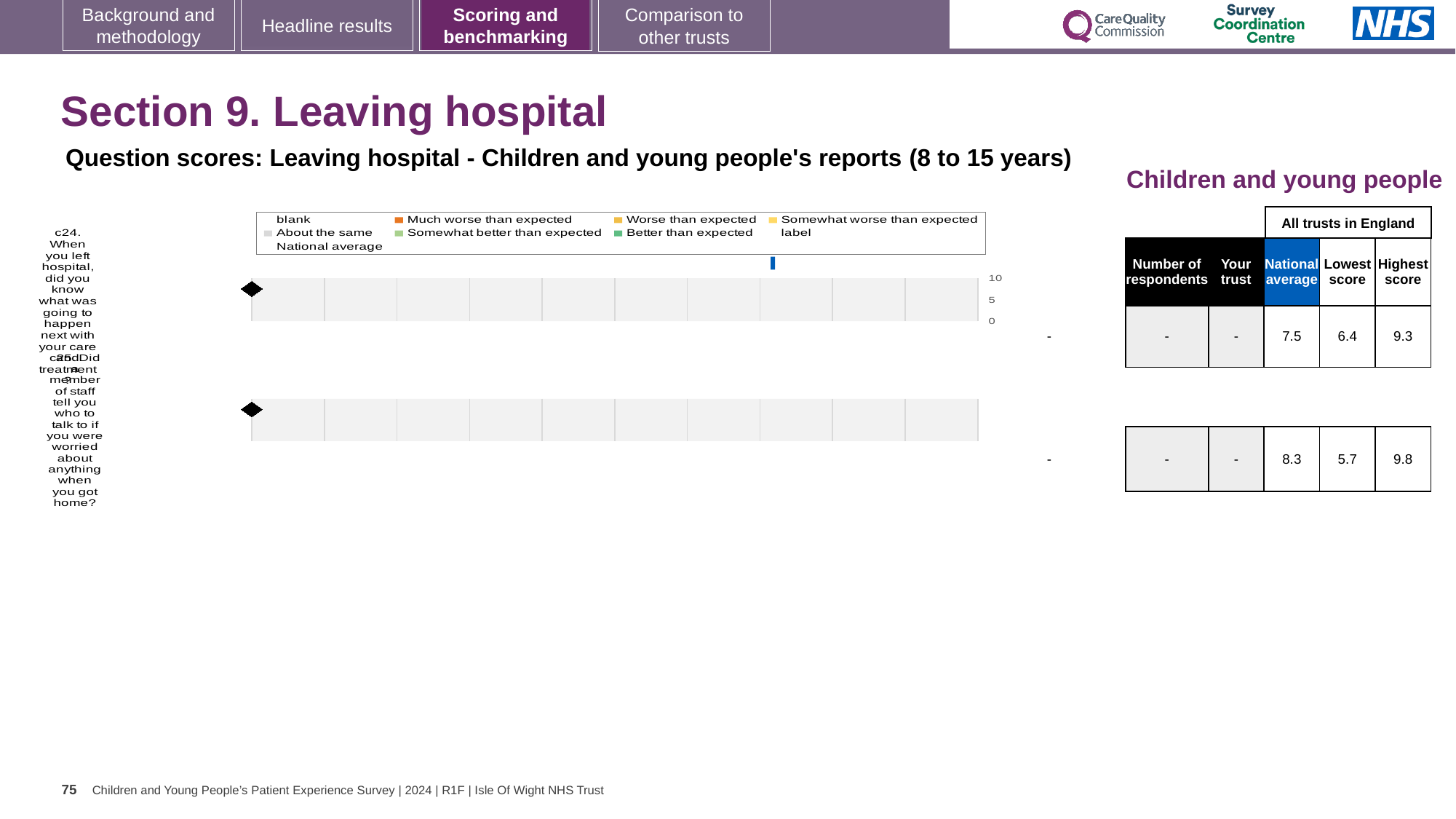
How many question categories (rows) does the chart show? 2 In the table beside the chart, what is the lowest score for question c24? 6.4 In the table beside the chart, what is the highest score for question c25? 9.8 In the table beside the chart, what is the highest score for question c24? 9.3 What kind of chart is shown on the slide? bar chart What is the highest value shown on the chart's numeric axis? 10 In the table beside the chart, what is the national average score for question c24? 7.5 In the table beside the chart, what is the national average score for question c25? 8.3 In the table beside the chart, what is the lowest score for question c25? 5.7 What is the first entry listed in the chart legend? blank In the table beside the chart, what is the difference between the highest and lowest scores for question c25? 4.1 In the table beside the chart, which question has the higher national average, c24 or c25? c25